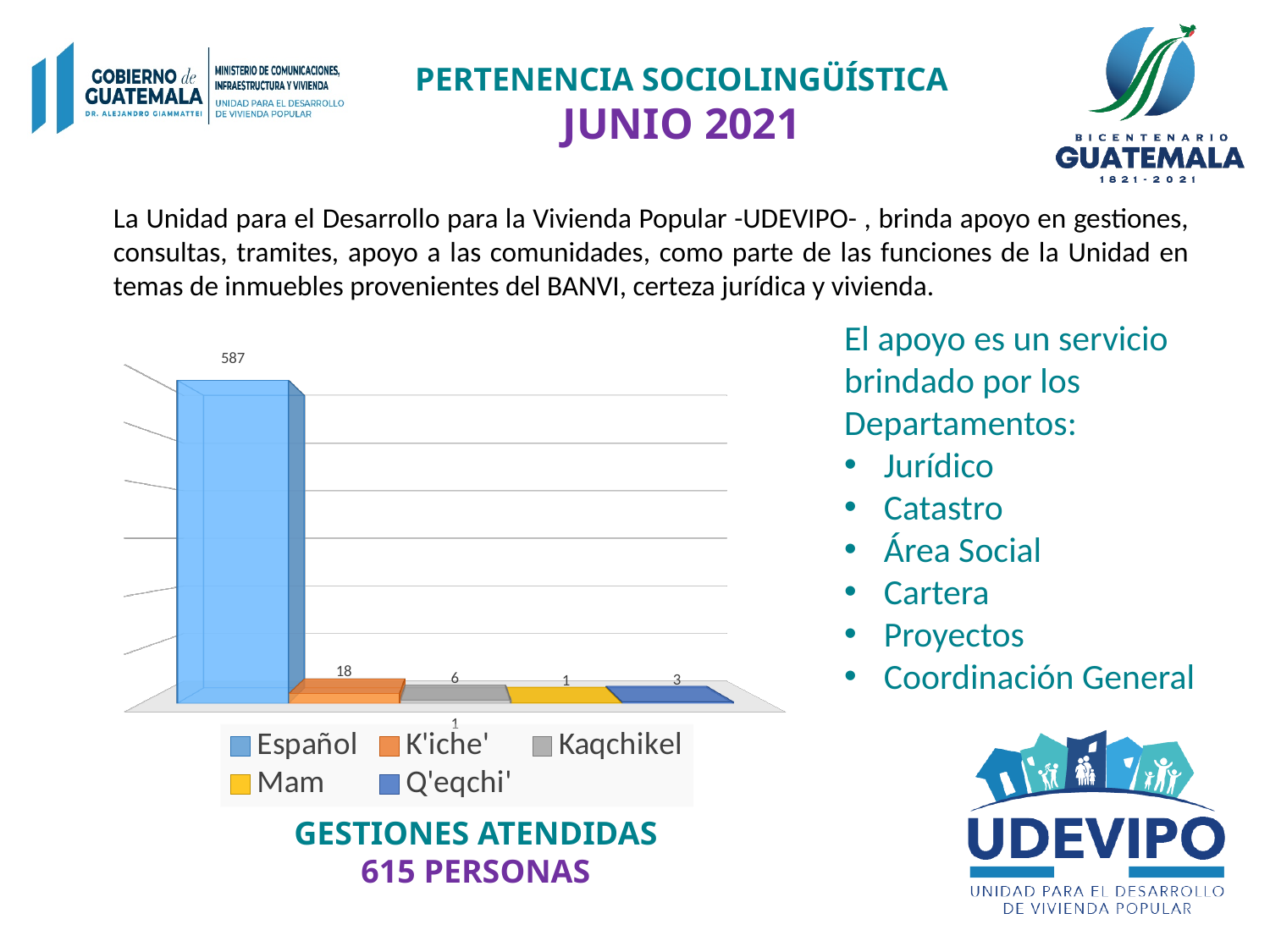
How many entries does the chart legend list? 5 Which is larger, the value for Kaqchikel or the value for Q'eqchi'? Kaqchikel What colour is the bar for K'iche' in the chart? Orange What is the value for K'iche' in the chart? 18 How many languages are shown in the chart? 5 Which language has the highest value in the chart? Español What is the value for Q'eqchi' in the chart? 3 What is the difference between the values for Español and K'iche'? 569 Which language has the lowest value in the chart? Mam What is the value for Español in the chart? 587 What kind of chart is shown on the slide? Bar chart What is the value for Kaqchikel in the chart? 6